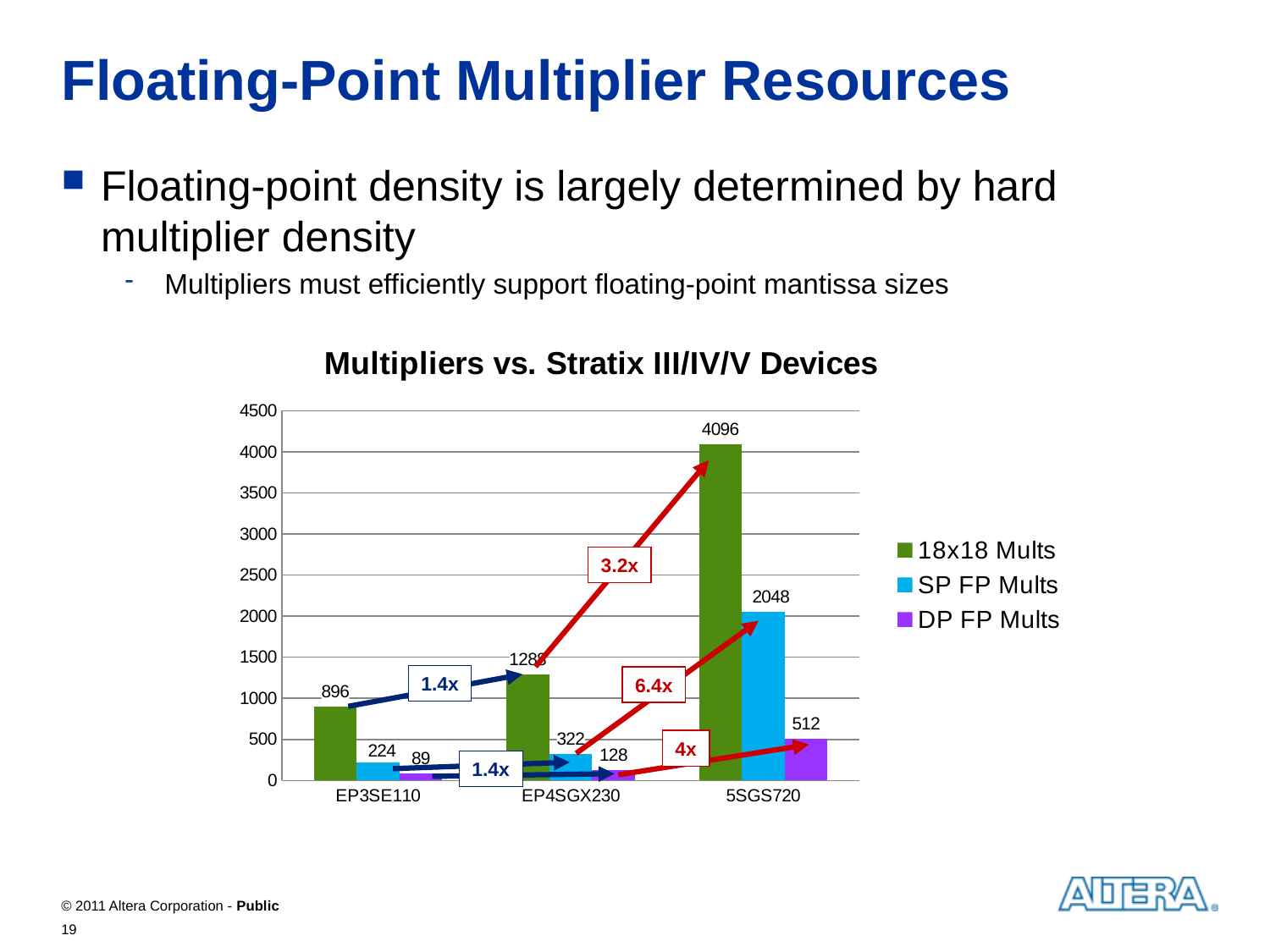
What is the value of 18x18 Mults for the 5SGS720 device? 4096 What is the value of DP FP Mults for the 5SGS720 device? 512 Which device has the lowest number of DP FP Mults? EP3SE110 What is the difference between SP FP Mults for 5SGS720 and SP FP Mults for EP3SE110? 1824 How many series does the chart legend list? 3 What is the value of DP FP Mults for the EP4SGX230 device? 128 Which is larger: SP FP Mults for EP4SGX230 or DP FP Mults for 5SGS720? DP FP Mults for 5SGS720 What is the value of SP FP Mults for the EP3SE110 device? 224 Which device has the highest number of 18x18 Mults? 5SGS720 What is the value of 18x18 Mults for the EP3SE110 device? 896 Do the 18x18 Mults values rise or fall from EP3SE110 to 5SGS720? rise How many devices are shown on the x axis of the chart? 3